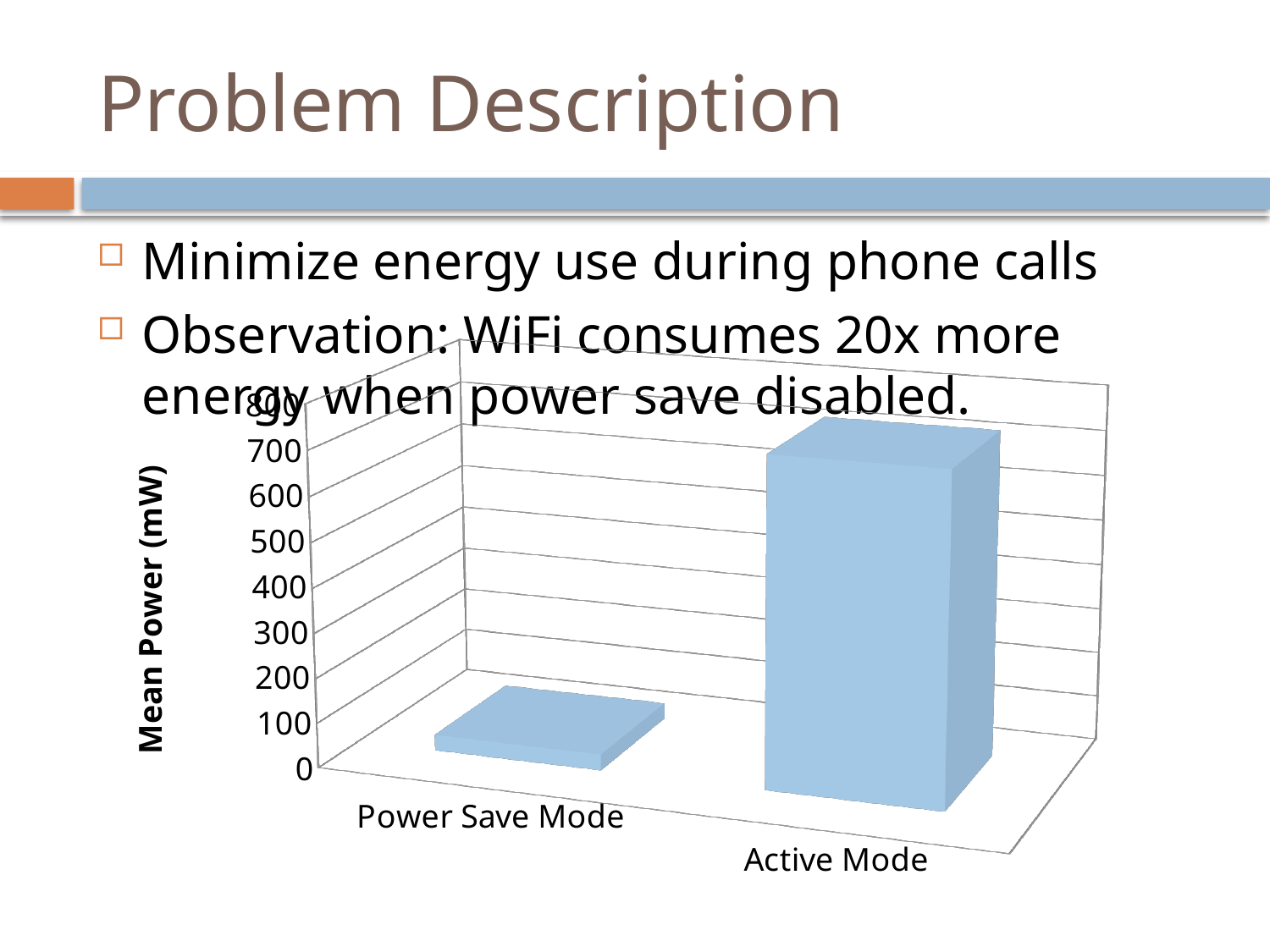
What is the label of the vertical axis of the chart? Mean Power (mW) Is the value for Power Save Mode greater or less than 100? less Is the value for Power Save Mode greater or less than 200? less Which category has the lowest mean power? Power Save Mode How many categories are plotted on the chart? 2 Which is larger, the mean power for Power Save Mode or for Active Mode? Active Mode Is the value for Active Mode greater or less than 400? greater What is the highest value shown on the vertical axis of the chart? 800 Which category has the highest mean power? Active Mode What kind of chart is shown on the slide? bar chart